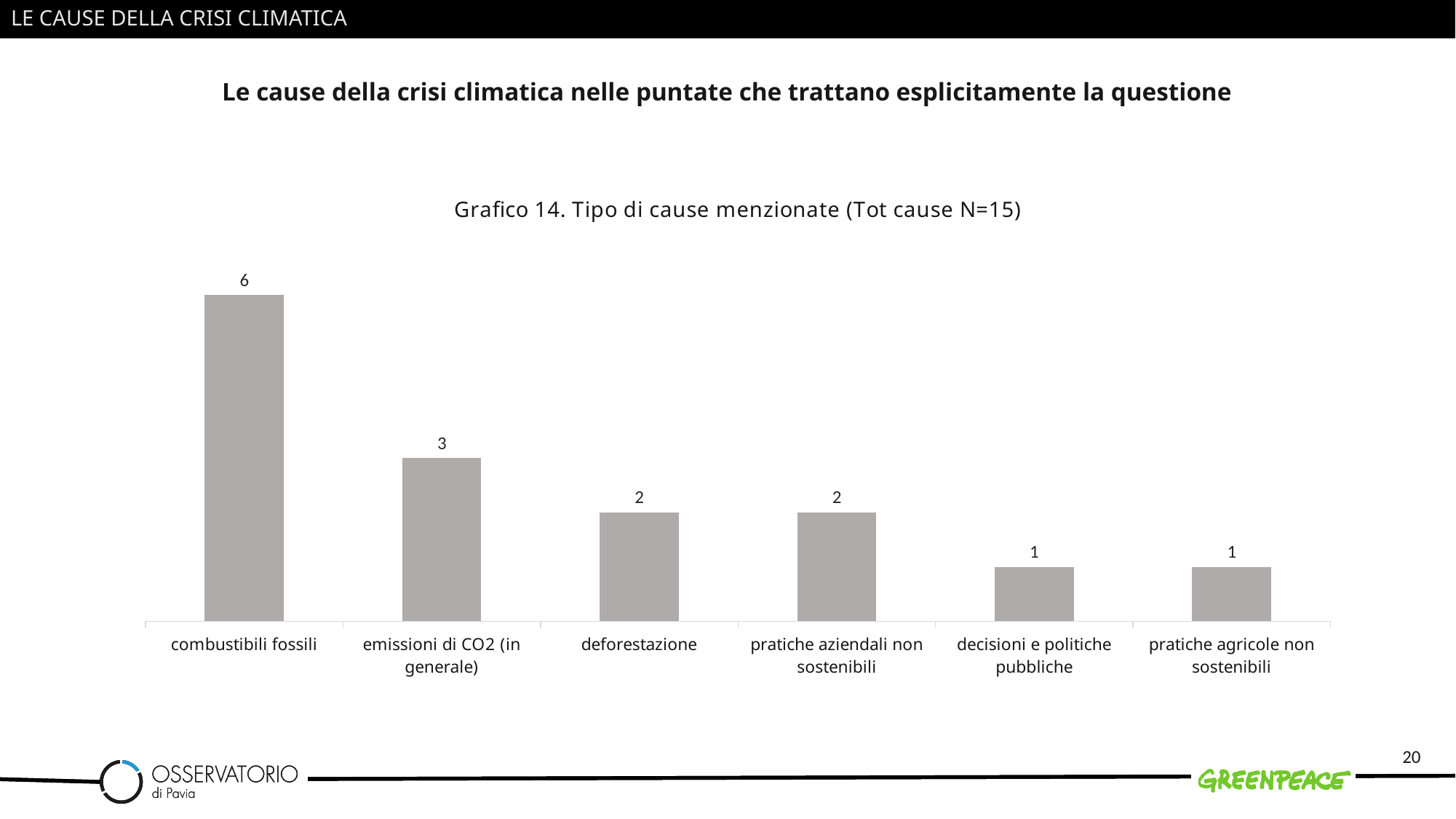
Do the values rise or fall from left to right along the x axis? fall What is the title of the chart? Grafico 14. Tipo di cause menzionate (Tot cause N=15) What kind of chart is shown on the slide? bar chart What is the difference between the values for deforestazione and pratiche agricole non sostenibili? 1 How many categories are shown in the chart? 6 What is the difference between the values for combustibili fossili and emissioni di CO2 (in generale)? 3 Which is larger, the value for emissioni di CO2 (in generale) or the value for pratiche aziendali non sostenibili? emissioni di CO2 (in generale) What is the value for combustibili fossili? 6 Which category has the highest value? combustibili fossili What is the value for deforestazione? 2 What is the value for decisioni e politiche pubbliche? 1 What is the value for emissioni di CO2 (in generale)? 3